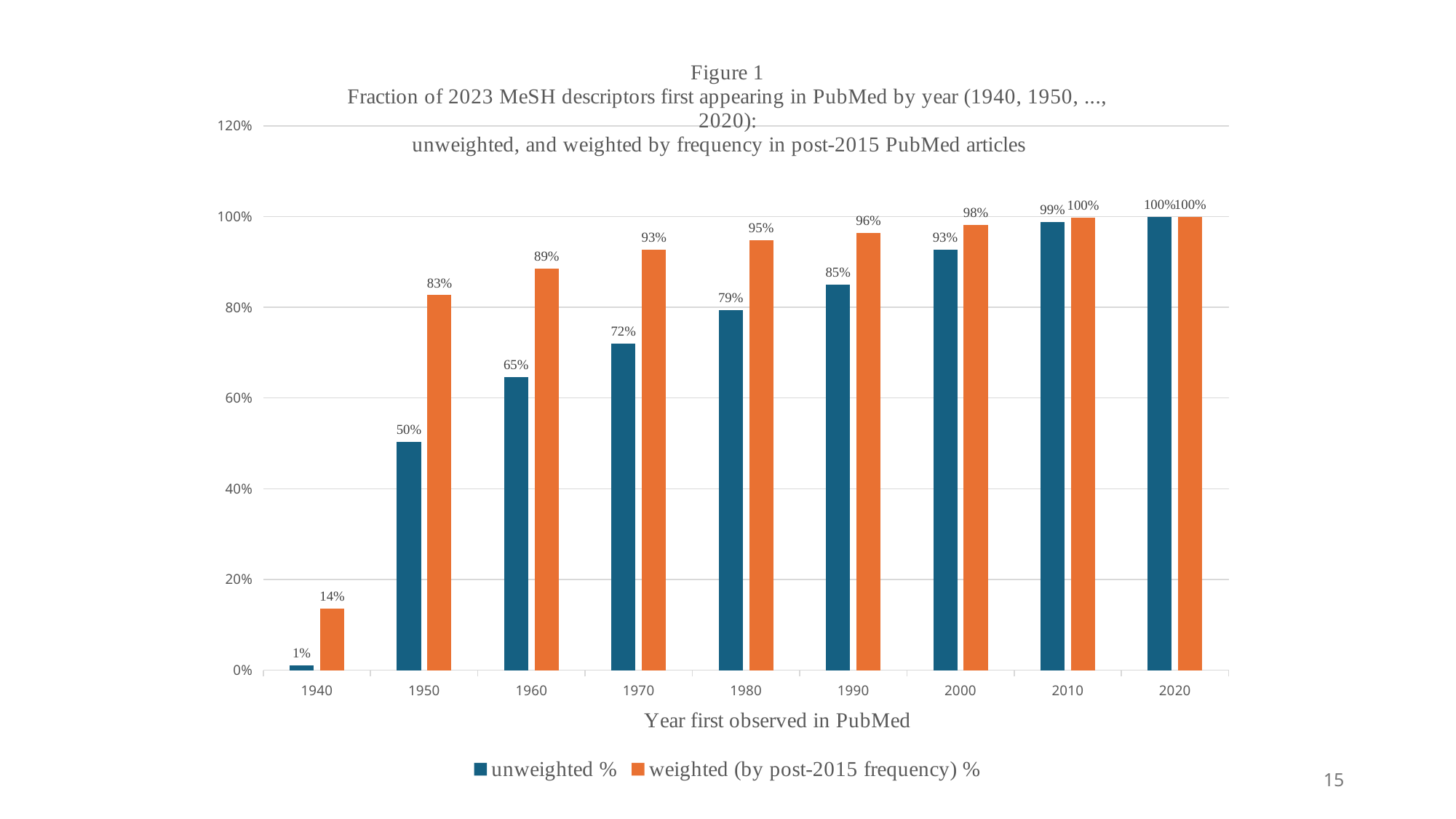
How many series does the legend list? 2 Do the unweighted % values rise or fall from 1940 to 2020? rise What is the unweighted % value for 1990? 85% What is the difference between the unweighted values for 1960 and 1970? 7% What is the unweighted % value for 1950? 50% What is the weighted (by post-2015 frequency) % value for 1970? 93% What kind of chart is shown on the slide? bar chart What is the difference between the weighted and unweighted values for 1950? 33% Which year has the lowest unweighted % value? 1940 What is the x-axis title of the chart? Year first observed in PubMed How many years are shown on the x axis? 9 Which is larger for 1980: the unweighted % or the weighted (by post-2015 frequency) %? weighted (by post-2015 frequency) %